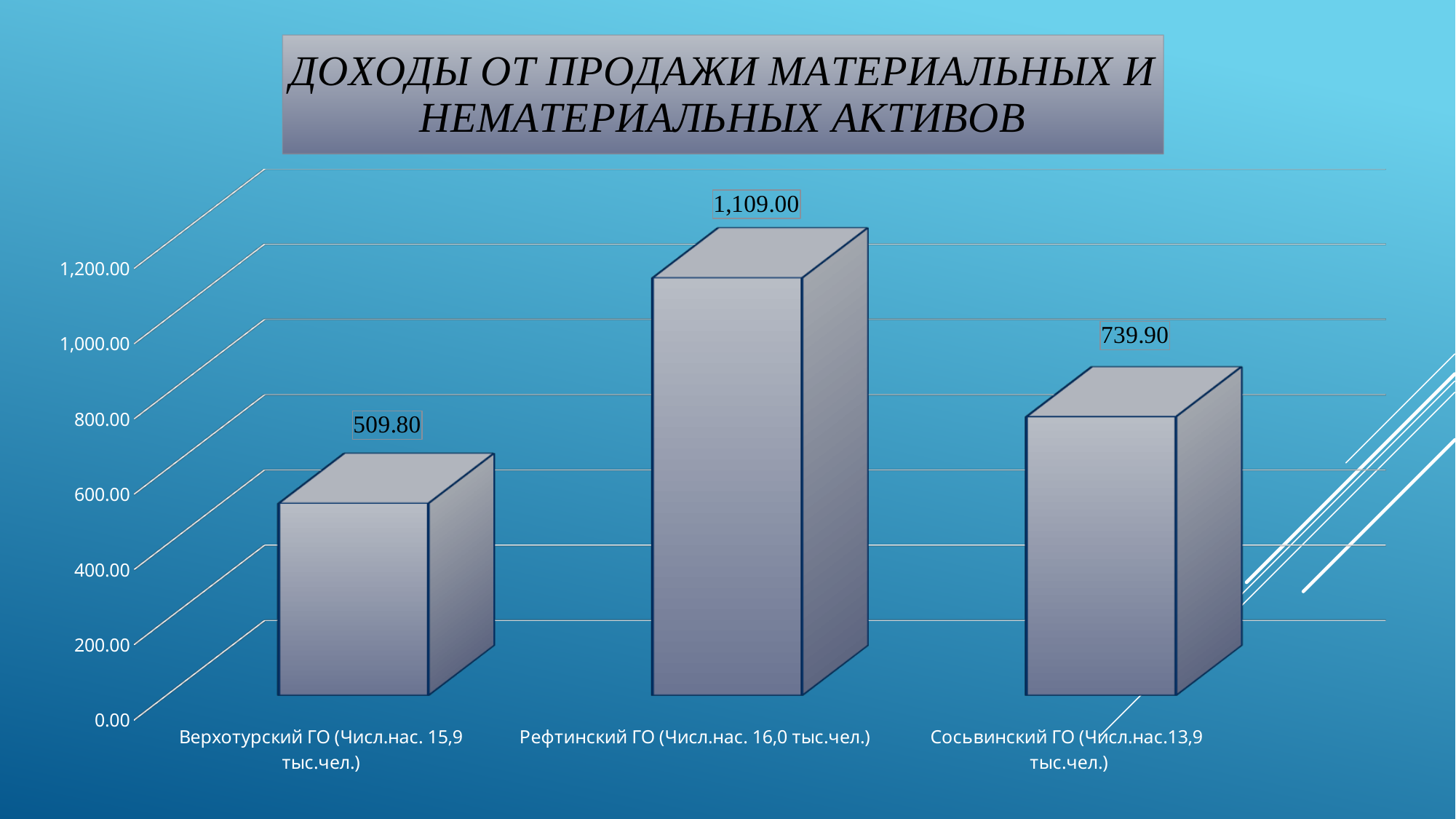
What is the value for Сосьвинский ГО? 739.90 What is the difference between the values for Рефтинский ГО and Верхотурский ГО? 599.20 What is the value for Рефтинский ГО? 1,109.00 Which category has the lowest value? Верхотурский ГО What is the difference between the values for Сосьвинский ГО and Верхотурский ГО? 230.10 Which is larger, the value for Сосьвинский ГО or the value for Верхотурский ГО? Сосьвинский ГО How many categories are shown on the chart? 3 What kind of chart is shown on the slide? bar chart What is the value for Верхотурский ГО? 509.80 Which category has the highest value? Рефтинский ГО Is the value for Сосьвинский ГО greater or less than 800.00? less What is the title of the chart? ДОХОДЫ ОТ ПРОДАЖИ МАТЕРИАЛЬНЫХ И НЕМАТЕРИАЛЬНЫХ АКТИВОВ